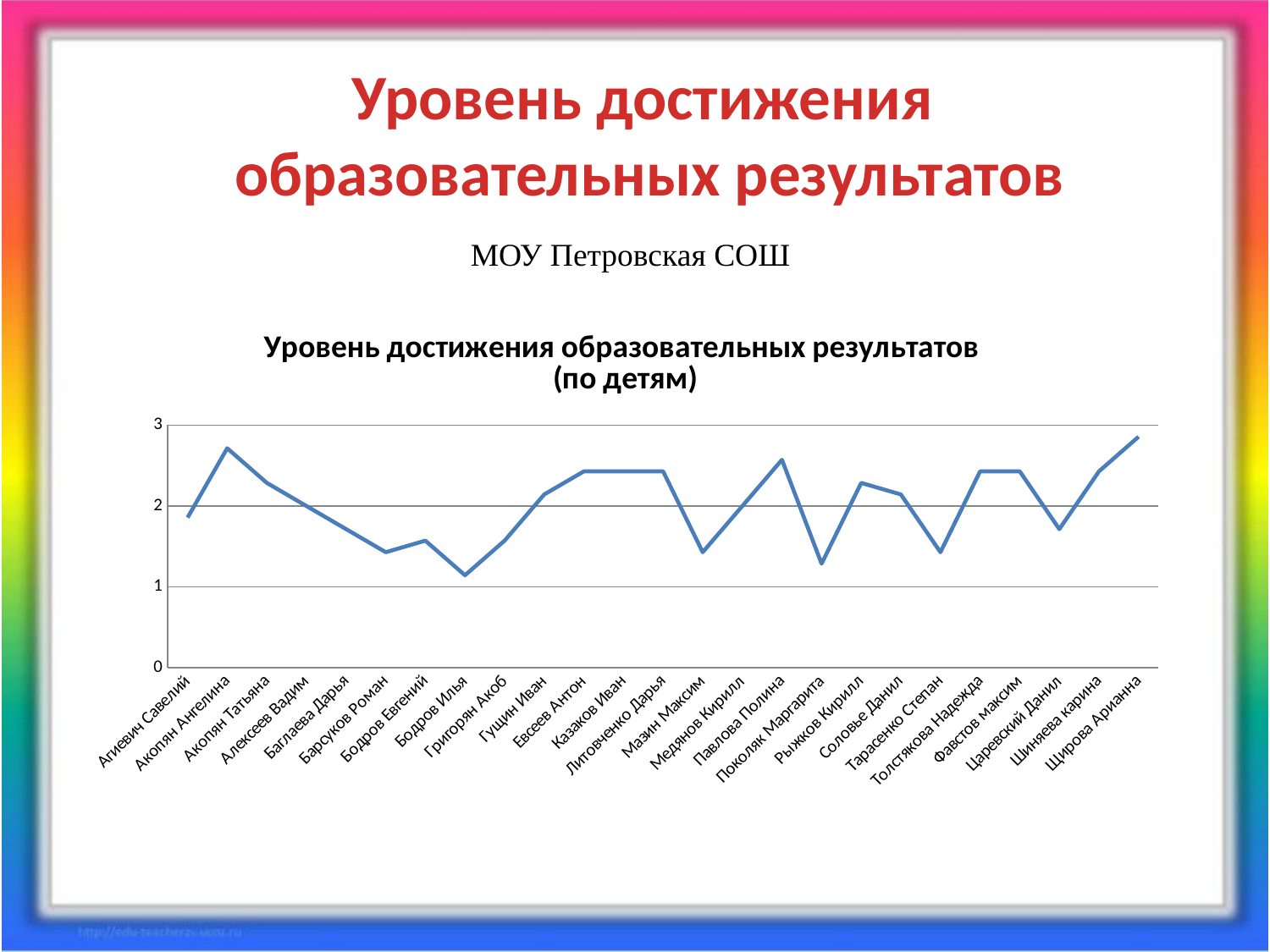
What kind of chart is shown on the slide? line chart What is the title of the chart? Уровень достижения образовательных результатов (по детям) Is the value for Барсуков Роман greater or less than 2? less Is the value for Акопян Ангелина greater or less than 2? greater Which child has the lowest value on the chart? Бодров Илья What is the highest tick value shown on the vertical axis of the chart? 3 Which has the larger value, Акопян Ангелина or Бодров Илья? Акопян Ангелина Is the value for Павлова Полина greater or less than 2? greater How many children (categories) are plotted along the x axis of the chart? 25